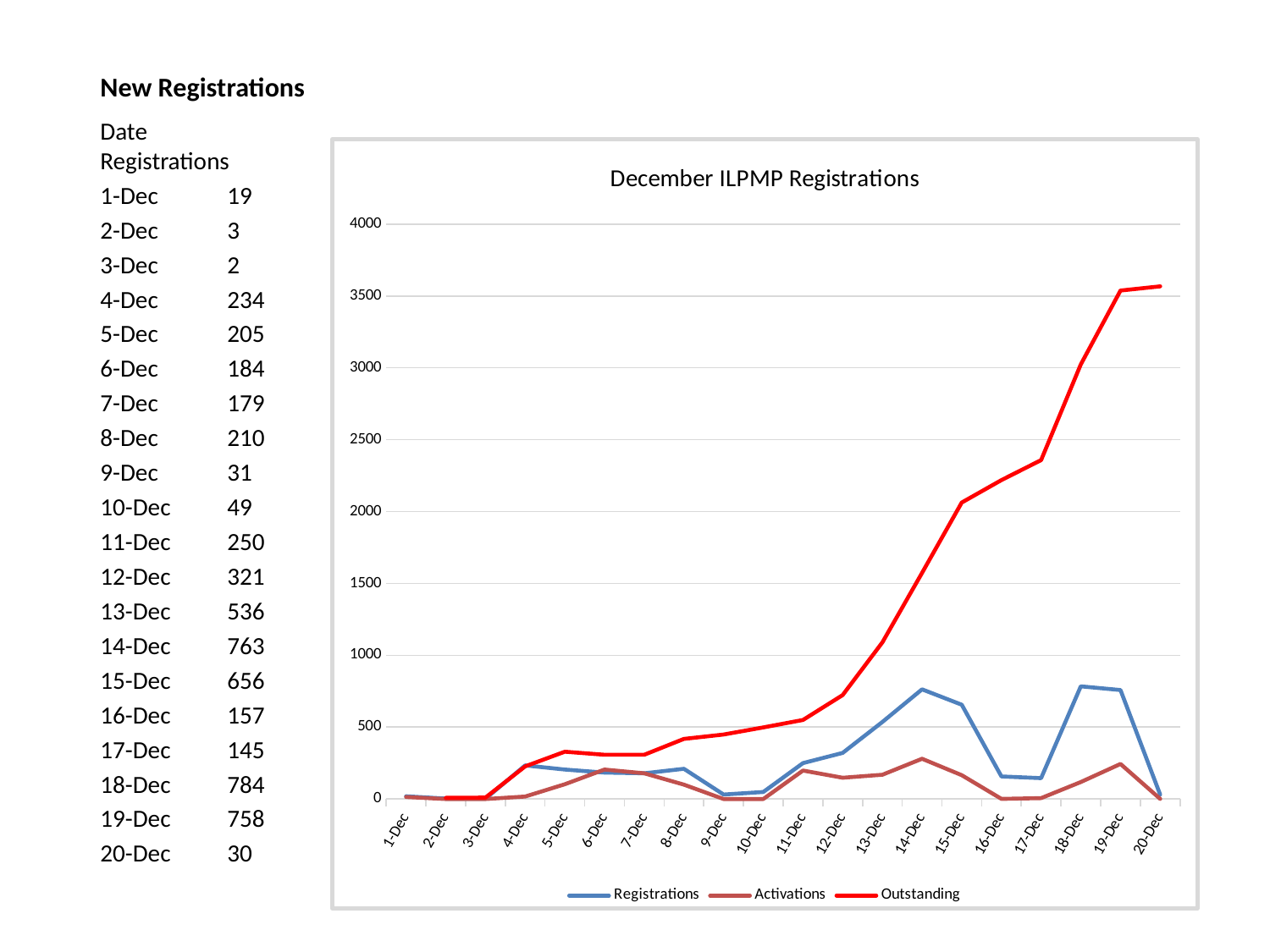
What kind of chart is shown on the slide? line chart On which date is the Registrations value highest? 18-Dec Is the Outstanding value for 20-Dec greater or less than 3000? greater What is the Registrations value for 11-Dec? 250 What is the Registrations value for 14-Dec? 763 What is the difference between the Registrations values for 13-Dec and 12-Dec? 215 On which date is the Registrations value lowest? 3-Dec Does the Outstanding series generally rise or fall from 1-Dec to 20-Dec? rise How many series does the legend of the December ILPMP Registrations chart list? 3 Is the Activations value for 14-Dec greater or less than 500? less Which date has the larger Registrations value, 4-Dec or 5-Dec? 4-Dec How many dates are plotted along the x axis of the December ILPMP Registrations chart? 20